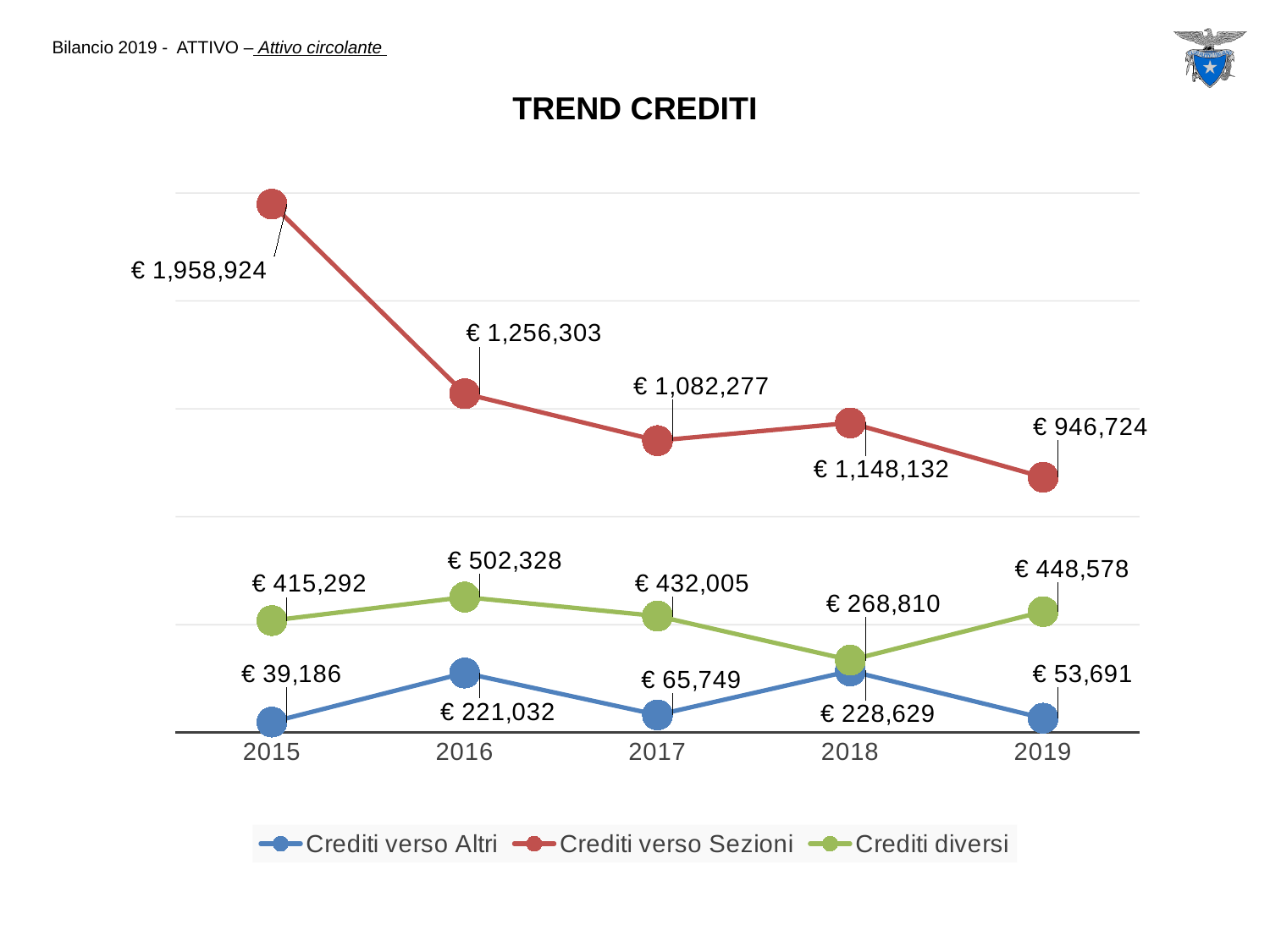
What is the difference between Crediti verso Sezioni in 2015 and in 2016? € 702,621 In which year is Crediti verso Sezioni at its lowest? 2019 In which year is Crediti verso Altri at its lowest? 2015 How many years are shown on the x axis? 5 What is the value of Crediti verso Altri in 2018? € 228,629 What is the value of Crediti verso Sezioni in 2019? € 946,724 Which is larger in 2018: Crediti verso Altri or Crediti diversi? Crediti diversi What is the value of Crediti diversi in 2016? € 502,328 What is the value of Crediti verso Sezioni in 2015? € 1,958,924 How many series does the legend list? 3 What type of chart is shown on the slide? Line chart In which year is Crediti diversi at its highest? 2016